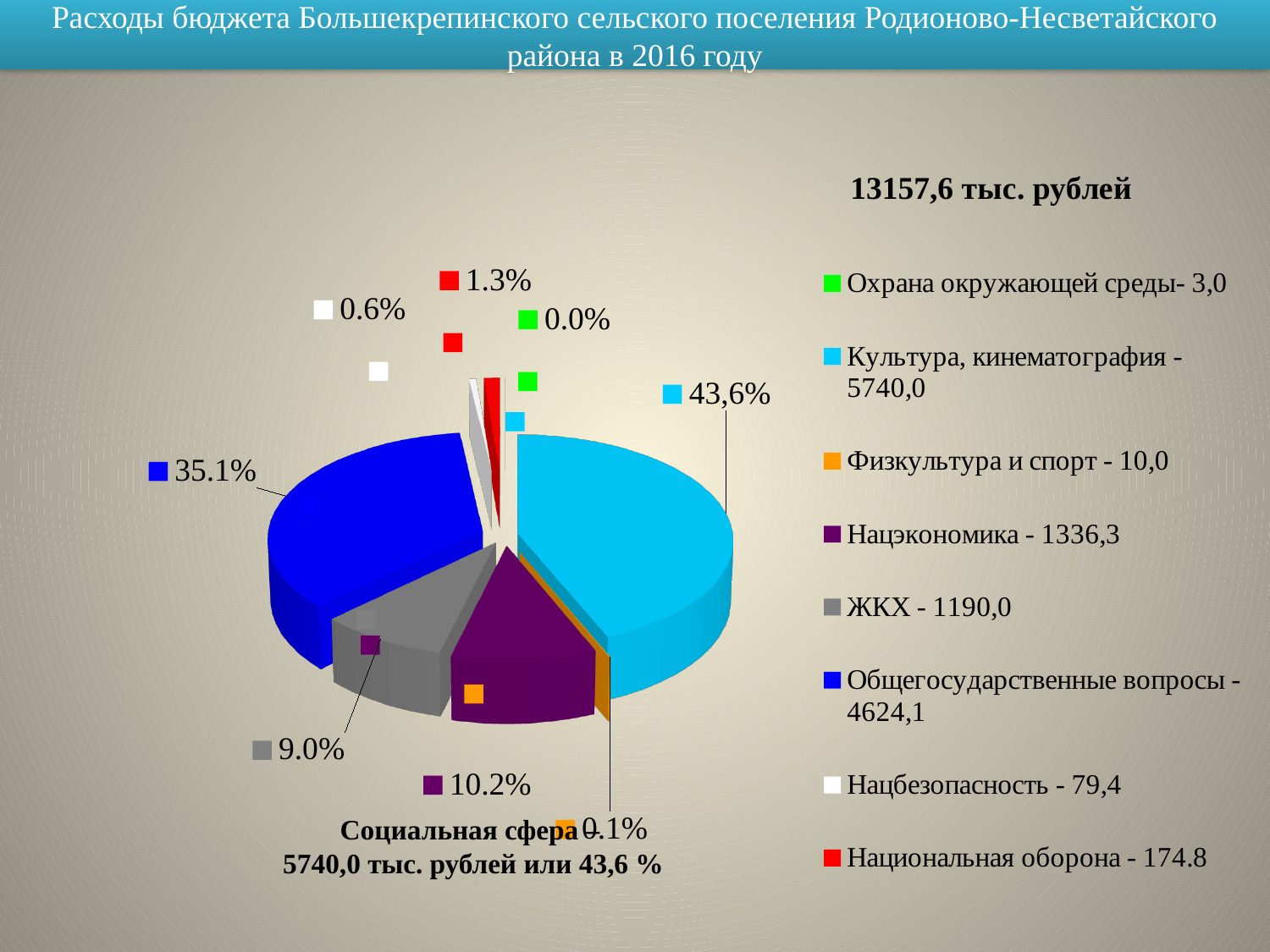
Which category has the smallest share, shown as 0.0%? Охрана окружающей среды Which is larger: the share for ЖКХ or the share for Нацэкономика? Нацэкономика What share of the pie does Культура, кинематография take? 43,6% How many categories does the legend of the pie chart list? 8 What share of the pie does Общегосударственные вопросы take? 35.1% Which category has the largest slice of the pie? Культура, кинематография What share of the pie does Нацэкономика take? 10.2% According to the legend, what is the value for Нацбезопасность? 79,4 What kind of chart is shown on the slide? pie chart What total amount in thousand rubles is shown above the legend? 13157,6 тыс. рублей